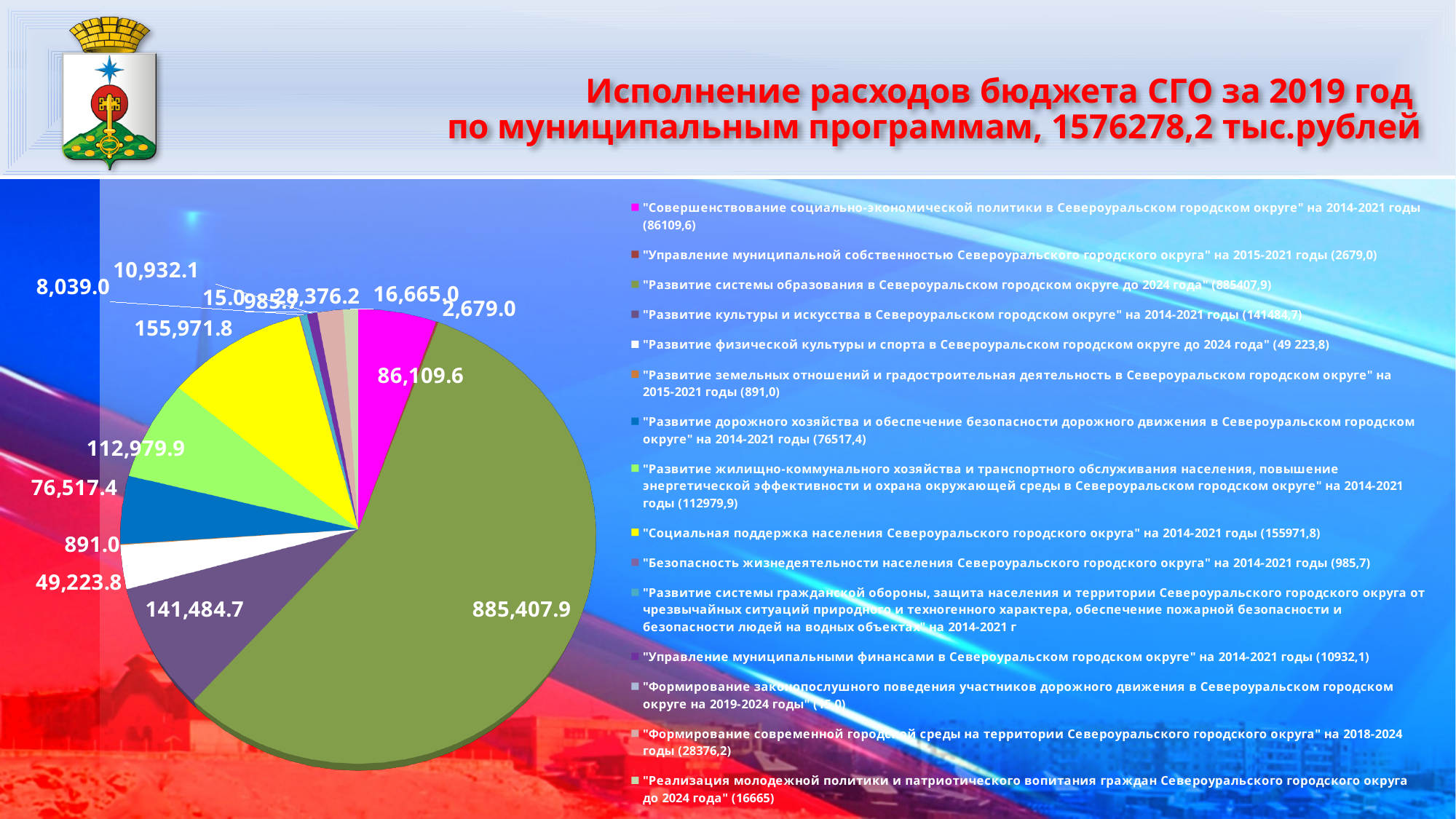
What is the value for "Управление муниципальной собственностью Североуральского городского округа"? 2,679.0 What is the value for "Социальная поддержка населения Североуральского городского округа"? 155,971.8 What is the value for "Развитие физической культуры и спорта в Североуральском городском округе до 2024 года"? 49,223.8 Which is larger: the slice for "Развитие жилищно-коммунального хозяйства..." (112,979.9) or the slice for "Развитие дорожного хозяйства..." (76,517.4)? "Развитие жилищно-коммунального хозяйства..." (112,979.9) Which program has the largest slice of the pie chart? "Развитие системы образования в Североуральском городском округе до 2024 года" What is the title of the slide? Исполнение расходов бюджета СГО за 2019 год по муниципальным программам, 1576278,2 тыс.рублей Which program has the smallest slice of the pie chart? "Формирование законопослушного поведения участников дорожного движения" (15.0) What is the difference between the values for "Социальная поддержка населения" (155,971.8) and "Развитие культуры и искусства" (141,484.7)? 14,487.1 What is the value for "Развитие культуры и искусства в Североуральском городском округе"? 141,484.7 What is the value of the largest slice of the pie chart? 885,407.9 What kind of chart is shown on the slide? pie chart How many programs (slices) does the pie chart show? 15